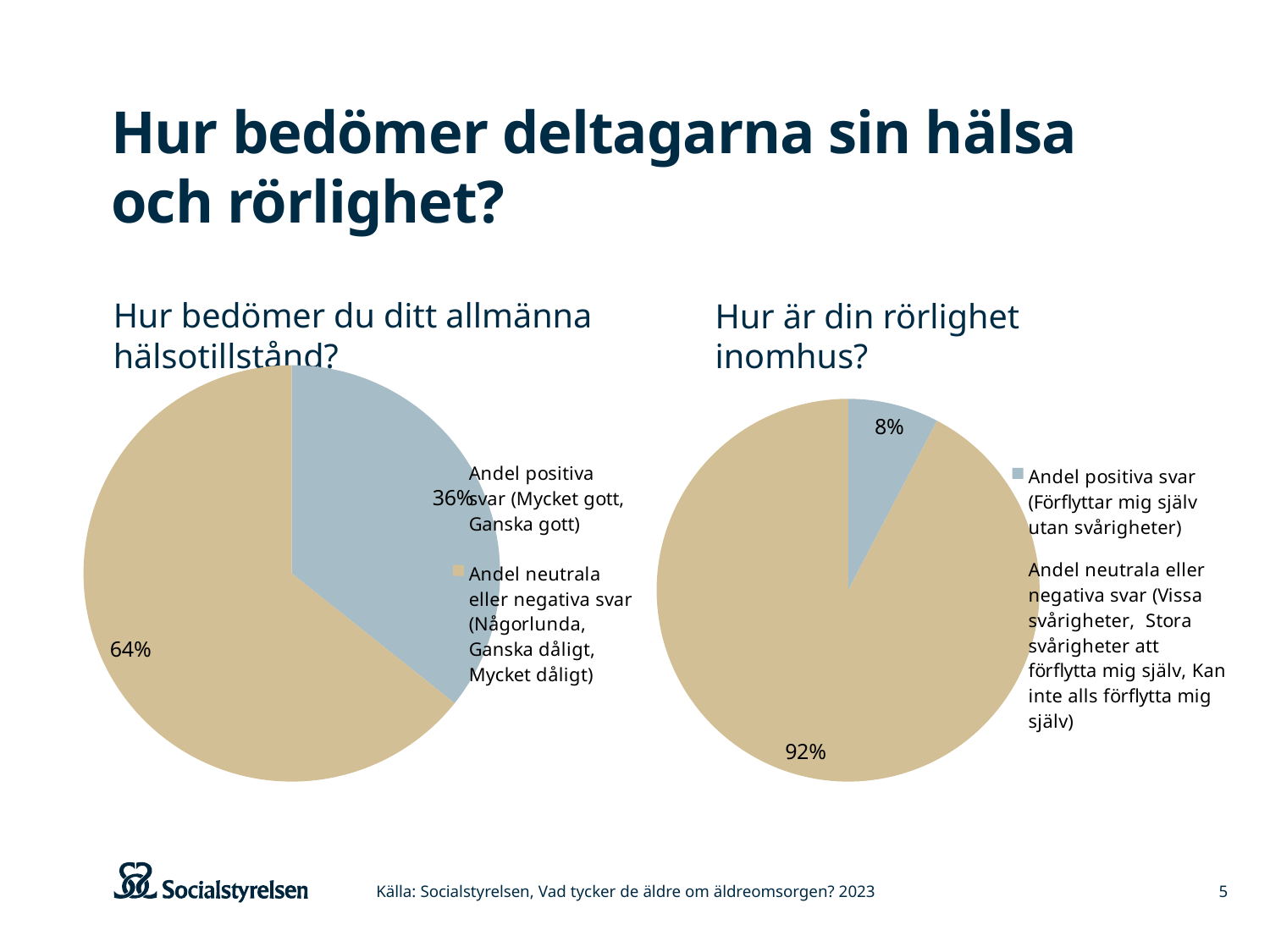
In the right chart (Hur är din rörlighet inomhus?), what share of responses are positive (Andel positiva svar)? 8% In the left chart (Hur bedömer du ditt allmänna hälsotillstånd?), what share of responses are neutral or negative (Andel neutrala eller negativa svar)? 64% How many charts are shown on the slide? 2 In the right chart (Hur är din rörlighet inomhus?), which category has the smallest slice? Andel positiva svar In the left chart (Hur bedömer du ditt allmänna hälsotillstånd?), what is the difference in percentage points between the neutral/negative share and the positive share? 28 percentage points In the left chart (Hur bedömer du ditt allmänna hälsotillstånd?), which category has the largest slice? Andel neutrala eller negativa svar In the right chart (Hur är din rörlighet inomhus?), what share of responses are neutral or negative (Andel neutrala eller negativa svar)? 92% In the right chart (Hur är din rörlighet inomhus?), what is the difference in percentage points between the neutral/negative share and the positive share? 84 percentage points What type of chart is used on this slide? Pie chart Which chart shows a larger share of positive responses, the left chart (allmänna hälsotillstånd) or the right chart (rörlighet inomhus)? The left chart (allmänna hälsotillstånd) In the left chart (Hur bedömer du ditt allmänna hälsotillstånd?), what share of responses are positive (Andel positiva svar)? 36% How many slices does the right chart (Hur är din rörlighet inomhus?) have? 2